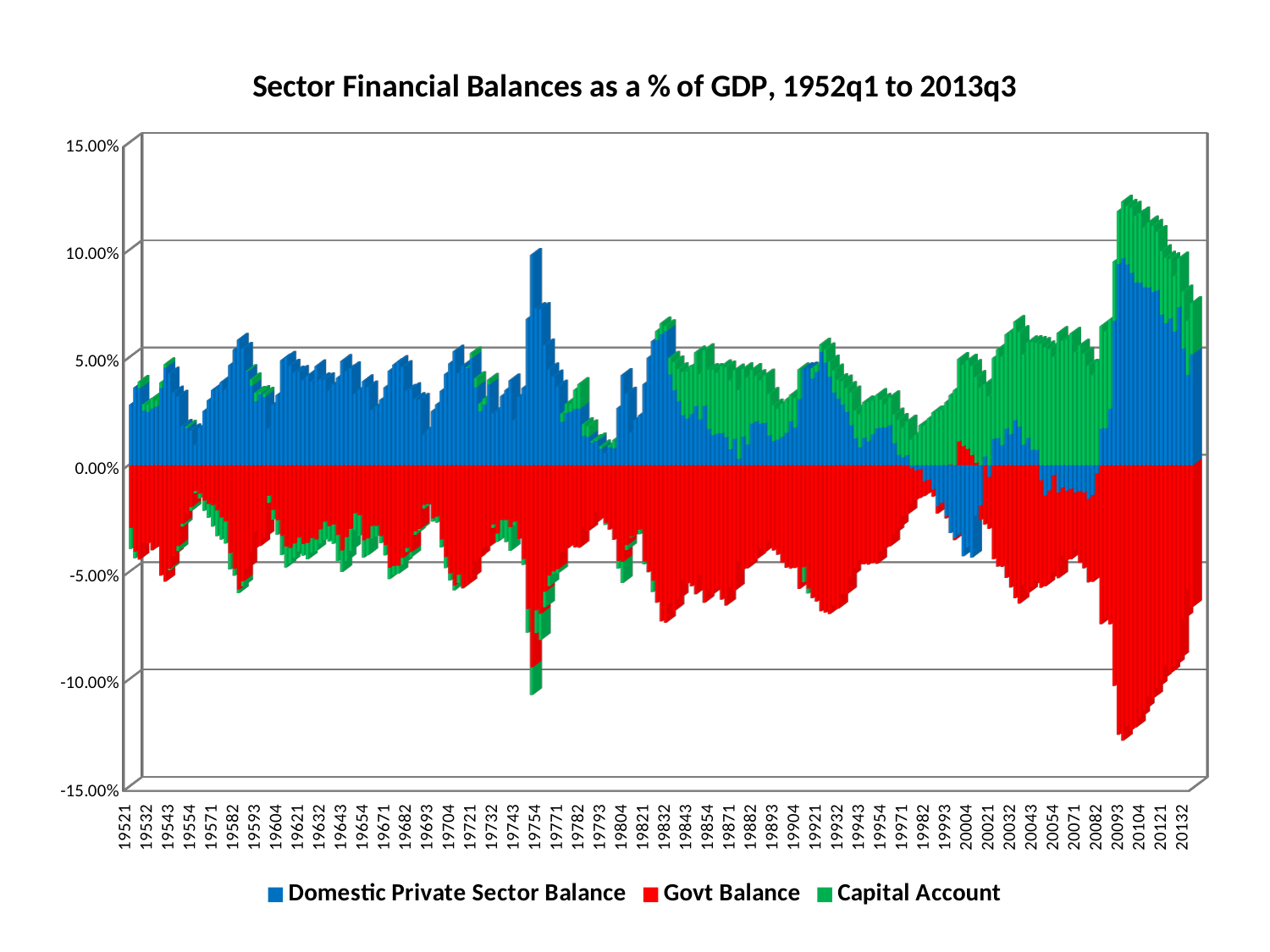
Is the value for Govt Balance at 20093 greater or less than -10.00%? less Is the value for Govt Balance at 20104 greater or less than -10.00%? less What is the highest value shown on the vertical axis? 15.00% Is the value for Domestic Private Sector Balance at 20093 greater or less than 5.00%? greater How many series does the legend list? 3 What kind of chart is shown on the slide? bar chart What is the title of the chart? Sector Financial Balances as a % of GDP, 1952q1 to 2013q3 Which series is shown in red in the legend? Govt Balance